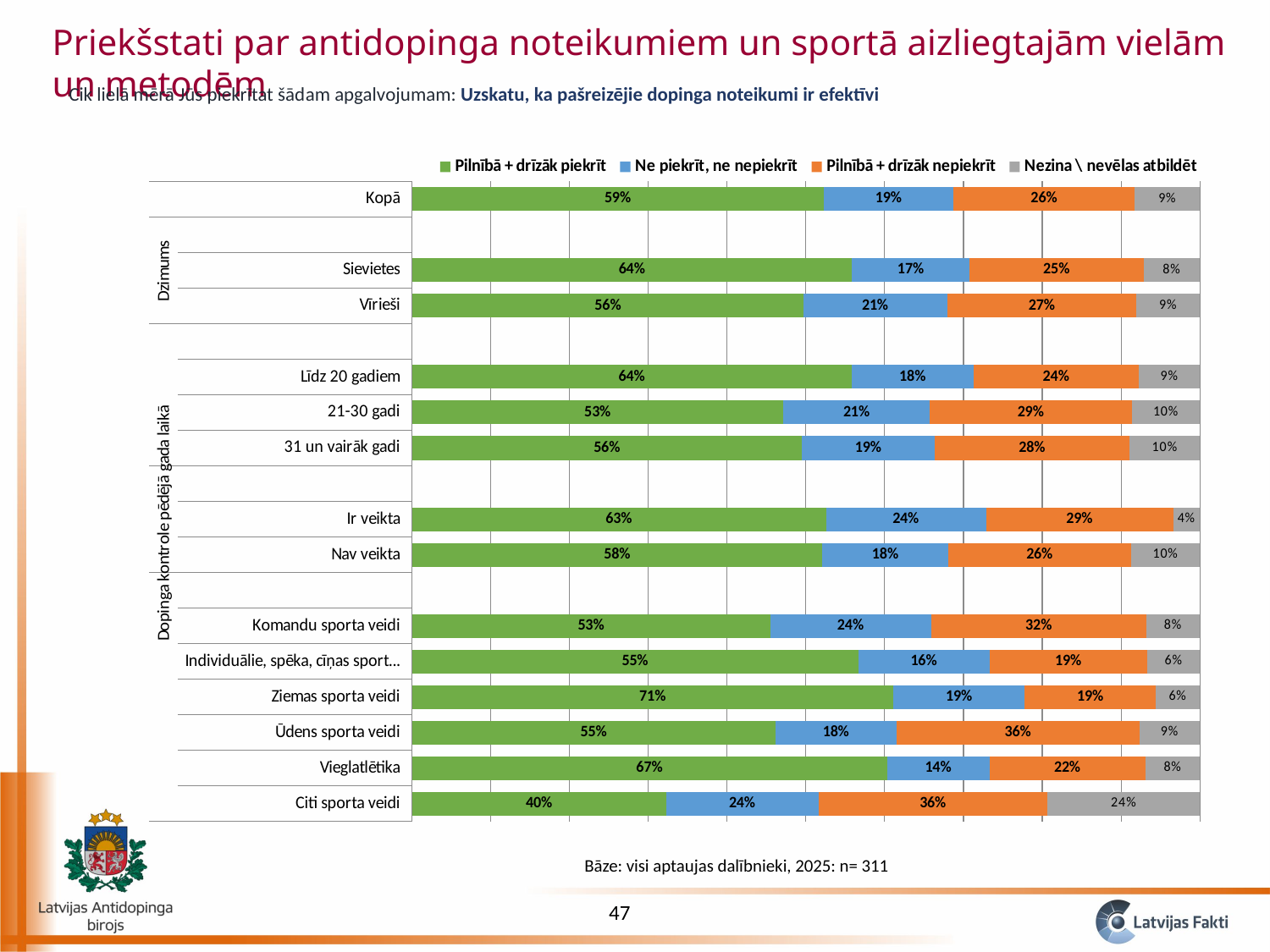
How many series does the legend list? 4 Which is larger: the 'Ne piekrīt, ne nepiekrīt' value for Komandu sporta veidi or for Vieglatlētika? Komandu sporta veidi What is the 'Pilnībā + drīzāk piekrīt' value for Kopā? 59% Which category has the lowest 'Pilnībā + drīzāk piekrīt' value? Citi sporta veidi What is the 'Nezina \ nevēlas atbildēt' value for Ir veikta? 4% What type of chart is shown on the slide? stacked bar chart Which category has the highest 'Pilnībā + drīzāk piekrīt' value? Ziemas sporta veidi Which category has the highest 'Nezina \ nevēlas atbildēt' value? Citi sporta veidi How many categories are plotted in the chart? 14 What is the 'Pilnībā + drīzāk nepiekrīt' value for Ūdens sporta veidi? 36% What is the difference between the 'Pilnībā + drīzāk piekrīt' values for Sievietes and Vīrieši? 8% What is the 'Ne piekrīt, ne nepiekrīt' value for 21-30 gadi? 21%